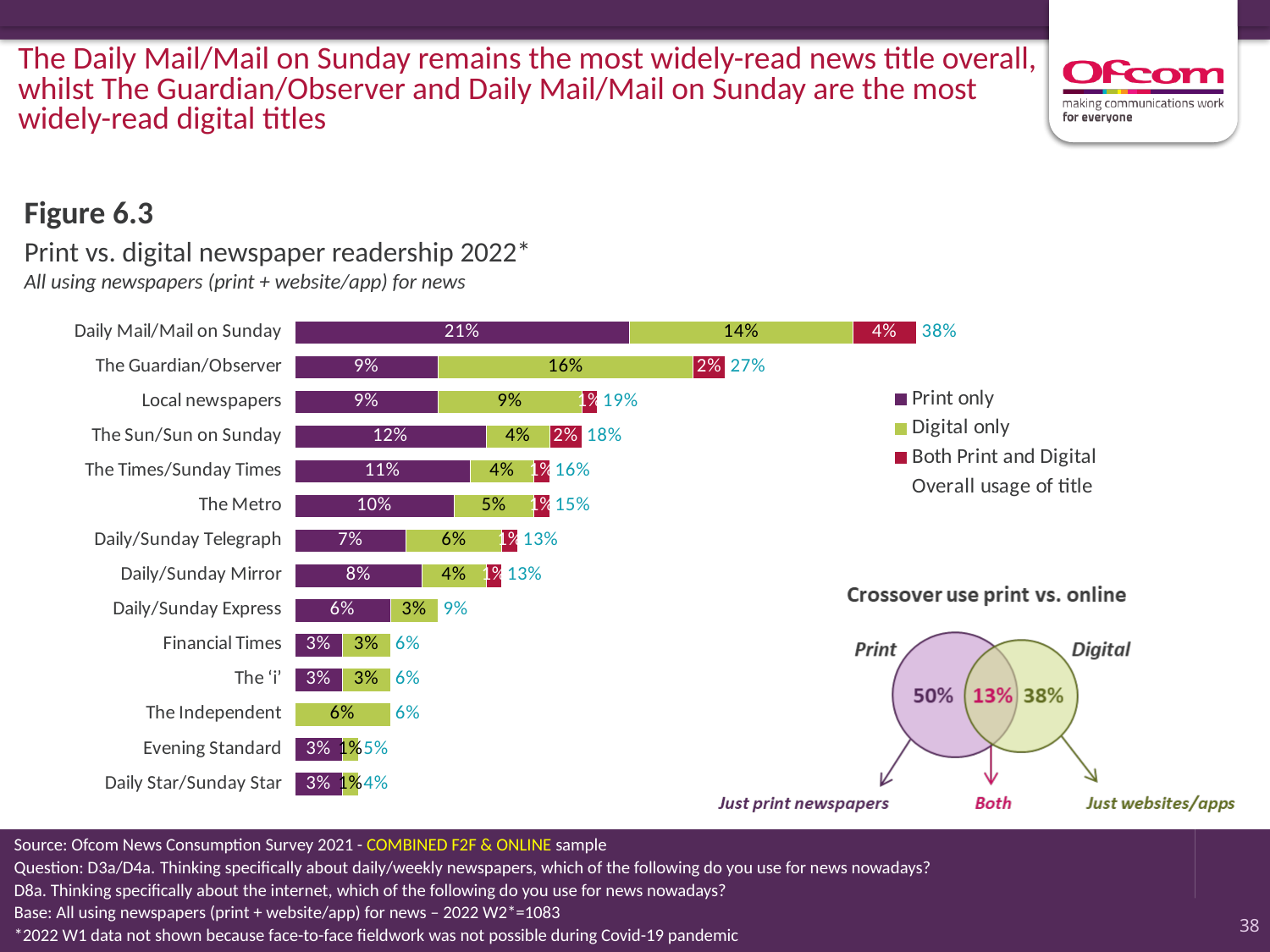
What is the Digital only value for The Guardian/Observer? 16% Which news title has the highest overall usage? Daily Mail/Mail on Sunday Which news title has the lowest overall usage? Daily Star/Sunday Star What colour represents Print only in the bar chart? Purple What is the difference in overall usage between Daily Mail/Mail on Sunday and The Guardian/Observer? 11 percentage points What is the difference between the Print only and Digital only values for The Metro? 5 percentage points What is the Both Print and Digital value for Daily Mail/Mail on Sunday? 4% How many news titles are listed in the bar chart? 14 What is the overall usage of title for The Sun/Sun on Sunday? 18% What is the Print only value for Daily Mail/Mail on Sunday? 21% What kind of chart is used in Figure 6.3 to show print vs. digital newspaper readership? Bar chart Which has the larger Digital only value, The Guardian/Observer or Daily Mail/Mail on Sunday? The Guardian/Observer